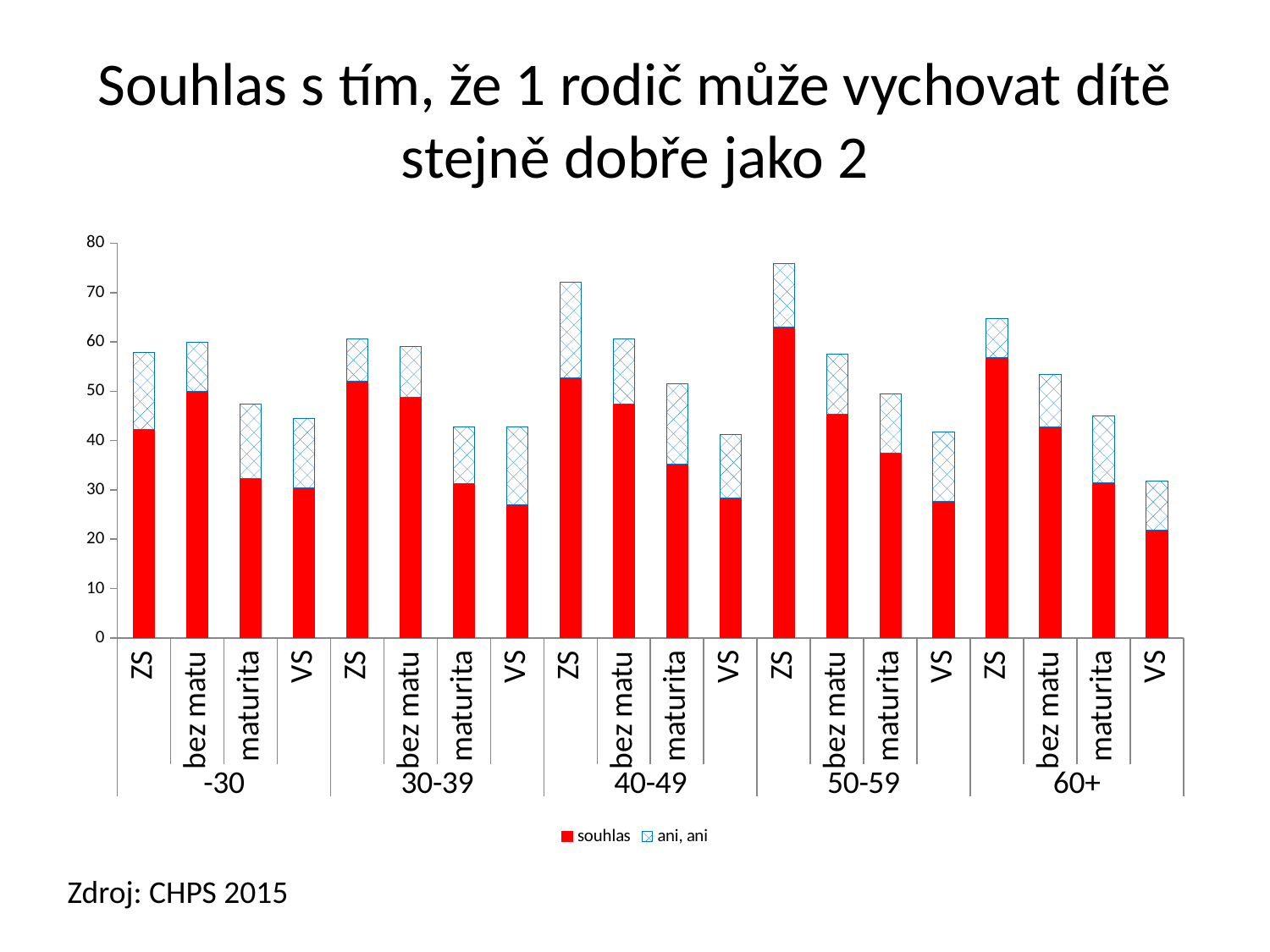
How many series does the legend list? 2 Is the 'souhlas' value for ZS in the 50-59 group greater or less than 60? greater Which bar has the lowest 'souhlas' value? VS in the 60+ group Is the 'souhlas' value for VS in the 60+ group greater or less than 30? less In the -30 group, which has the larger 'souhlas' value: ZS or bez matu? bez matu Which bar has the highest 'souhlas' value? ZS in the 50-59 group Is the total height of the stacked bar for ZS in the 40-49 group greater or less than 70? greater How many age groups are shown along the x axis? 5 In the 40-49 group, which has the larger 'souhlas' value: maturita or VS? maturita What are the two legend entries of the chart? souhlas; ani, ani How many bars are plotted in the chart? 20 What kind of chart is shown on the slide? bar chart